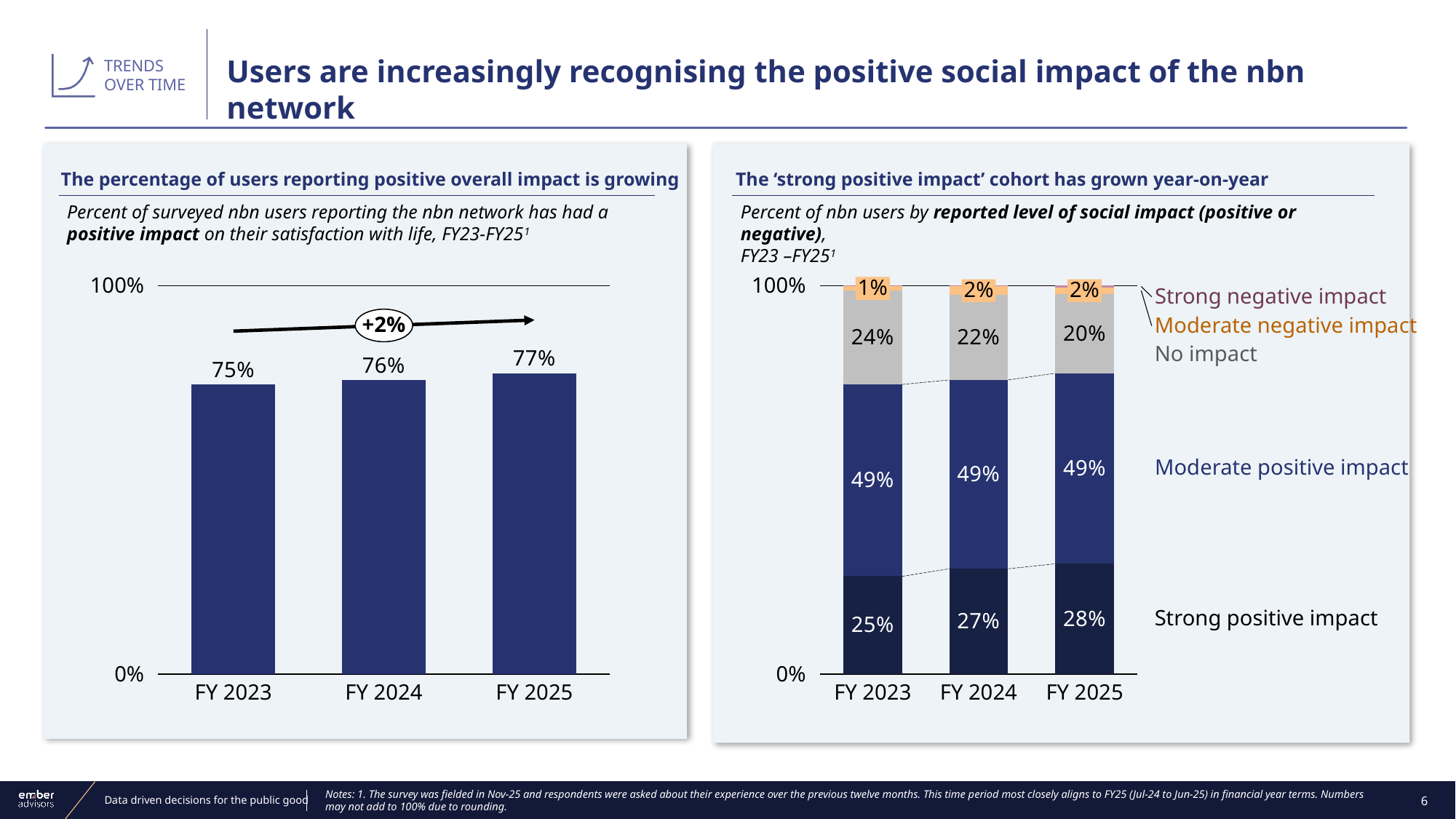
In the right chart, what is the difference between the 'Moderate positive impact' and 'Strong positive impact' shares in FY 2025? 21% In the left chart, which fiscal year has the lowest percentage of users reporting a positive impact? FY 2023 In the left chart, how many fiscal years are plotted? 3 In the right chart, what percentage of users reported a strong positive impact in FY 2024? 27% In the right chart, which fiscal year has the highest share of users reporting a strong positive impact? FY 2025 What kind of chart is the left chart? bar chart In the left chart, do the values rise or fall from FY 2023 to FY 2025? rise In the right chart, is the 'No impact' share larger in FY 2023 or FY 2025? FY 2023 In the right chart, what percentage of users reported no impact in FY 2023? 24% In the left chart, what percentage of users reported a positive impact in FY 2025? 77% In the right chart, how many impact levels does the legend list? 5 In the left chart, what is the difference between the FY 2025 and FY 2023 values? 2%